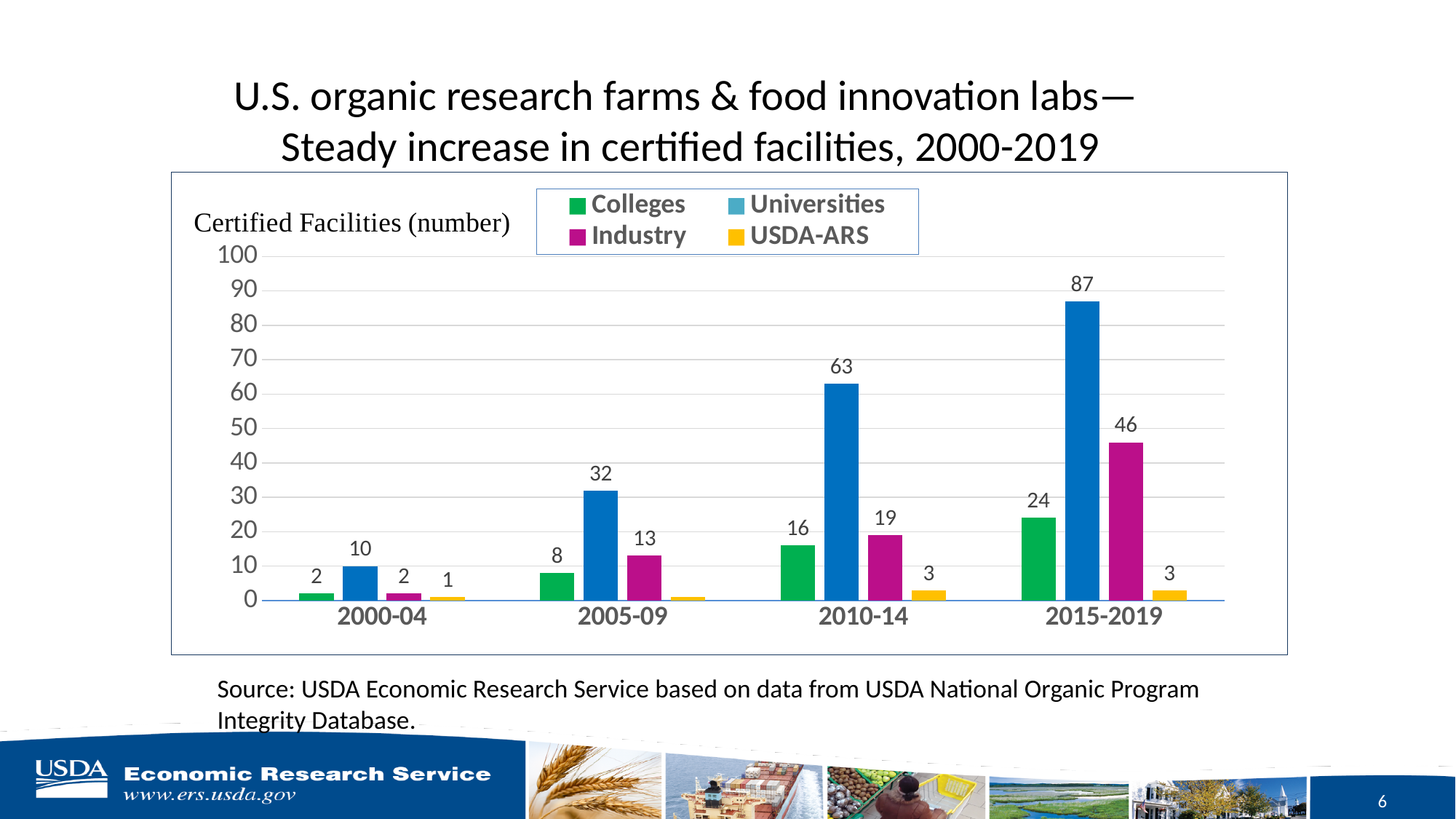
What is the value for USDA-ARS in 2000-04? 1 Do the Colleges values rise or fall from 2000-04 to 2015-2019? Rise Which period has the highest value for Universities? 2015-2019 What is the difference between the Universities value in 2015-2019 and in 2010-14? 24 How many series does the legend list? 4 What is the value for Industry in 2010-14? 19 Which period has the lowest value for Colleges? 2000-04 Which is larger in 2015-2019, the Industry value or the Colleges value? Industry How many periods are shown on the x axis? 4 What is the value for Colleges in 2005-09? 8 What kind of chart is shown on the slide? Bar chart What is the value for Universities in 2015-2019? 87